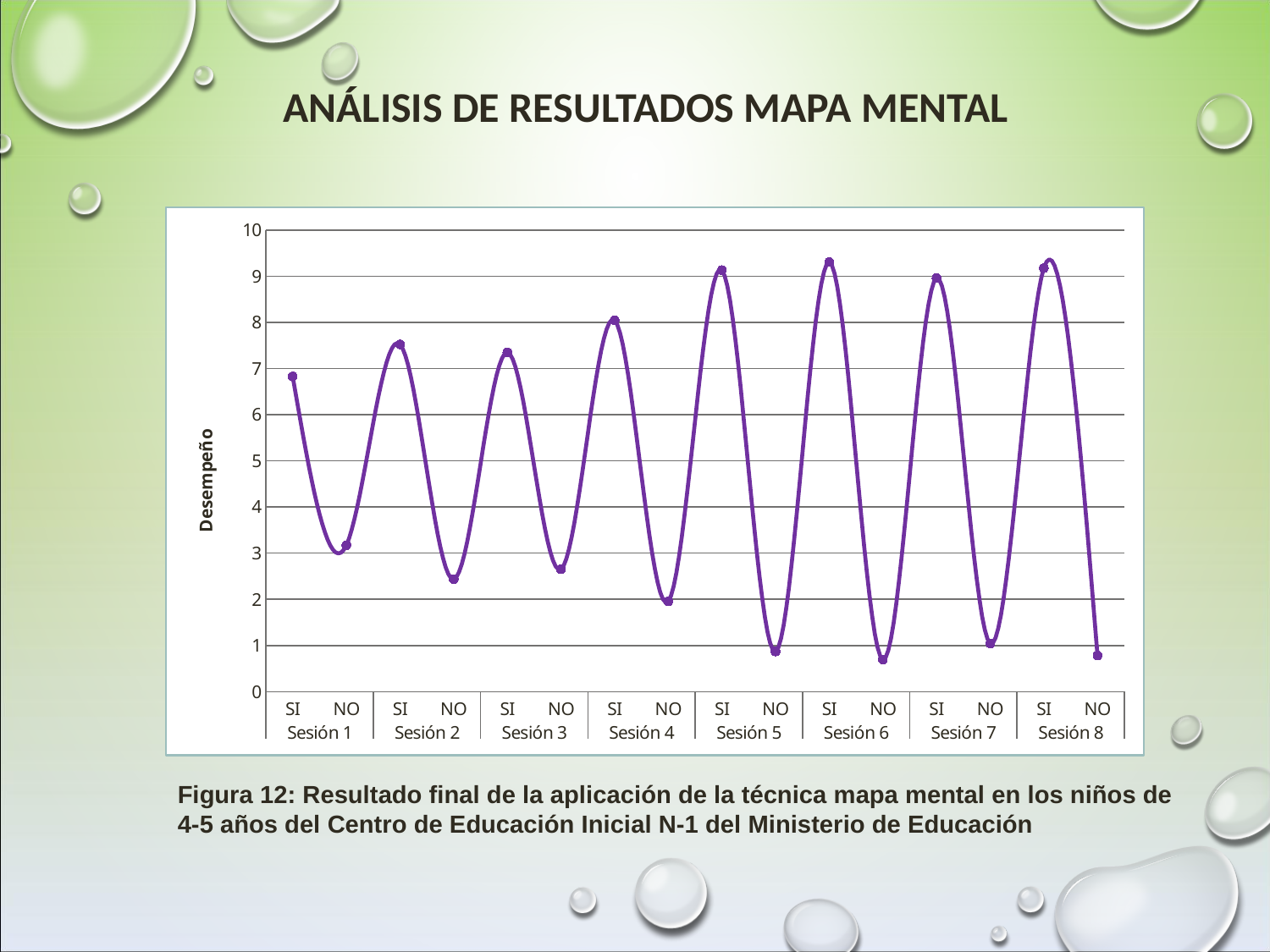
Which is larger, the SI value in Sesión 1 or the SI value in Sesión 5? Sesión 5 How many sessions (Sesión) are shown along the x axis of the chart? 8 Which session has the lowest SI value? Sesión 1 Do the SI values generally rise or fall from Sesión 1 to Sesión 8? rise How many data points are plotted on the line in the chart? 16 What is the maximum value shown on the vertical axis of the chart? 10 What kind of chart is shown on the slide? line chart Is the value for SI in Sesión 1 greater or less than 6? greater What is the label of the vertical axis of the chart? Desempeño Is the value for NO in Sesión 2 greater or less than 3? less Is the value for NO in Sesión 7 greater or less than 2? less